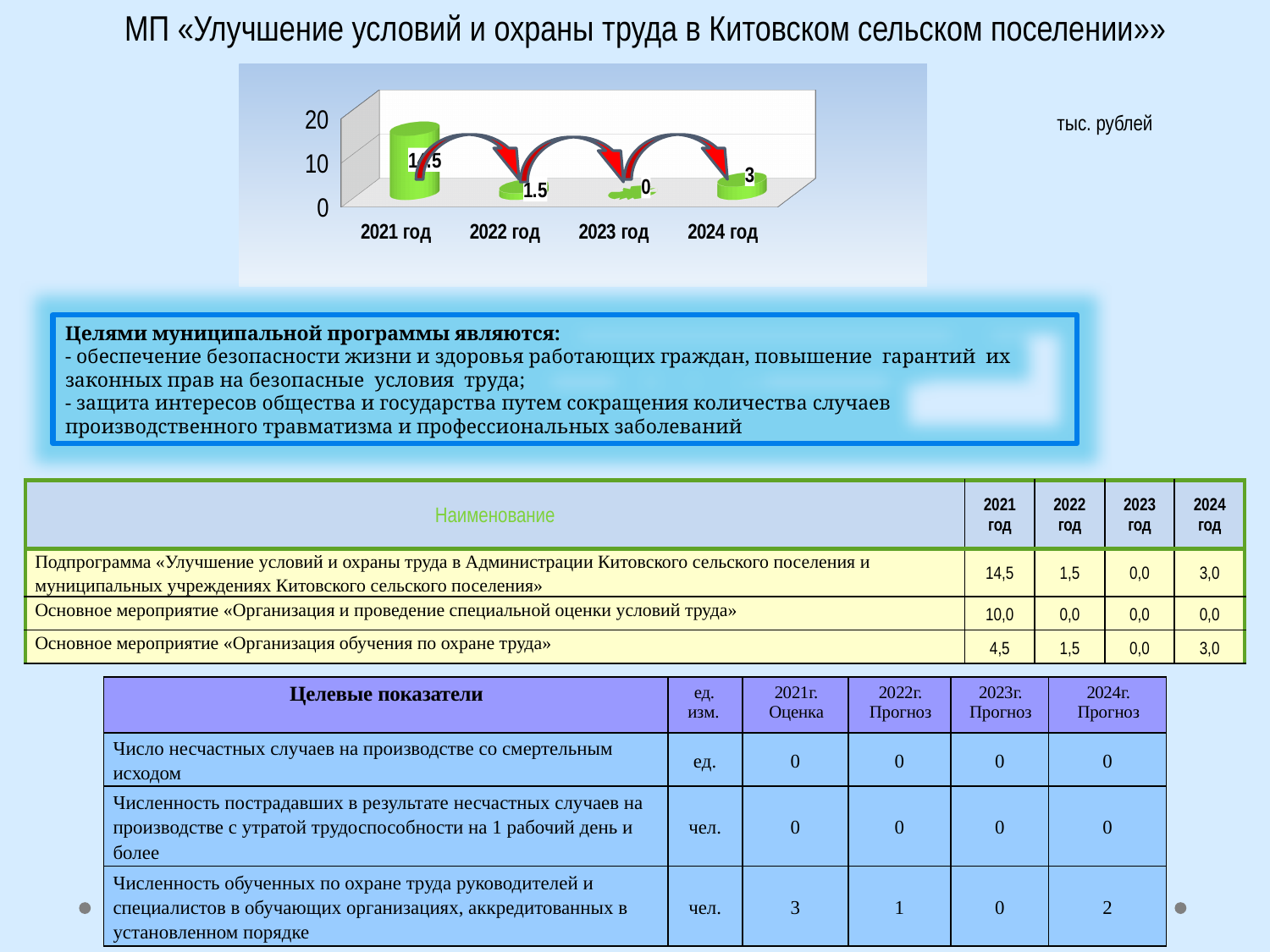
What is the value shown for 2022 год on the chart? 1.5 Is the value for 2021 год on the chart greater or less than 10? greater What is the value shown for 2021 год on the chart? 14.5 Which is larger on the chart, the value for 2022 год or the value for 2024 год? 2024 год What is the value shown for 2024 год on the chart? 3 What is the difference between the values for 2021 год and 2024 год on the chart? 11.5 What type of chart is shown on the slide? bar chart What unit of measurement is indicated next to the chart? тыс. рублей Which year has the highest value on the chart? 2021 год How many years (categories) are shown on the chart? 4 Which year has the lowest value on the chart? 2023 год What is the value shown for 2023 год on the chart? 0